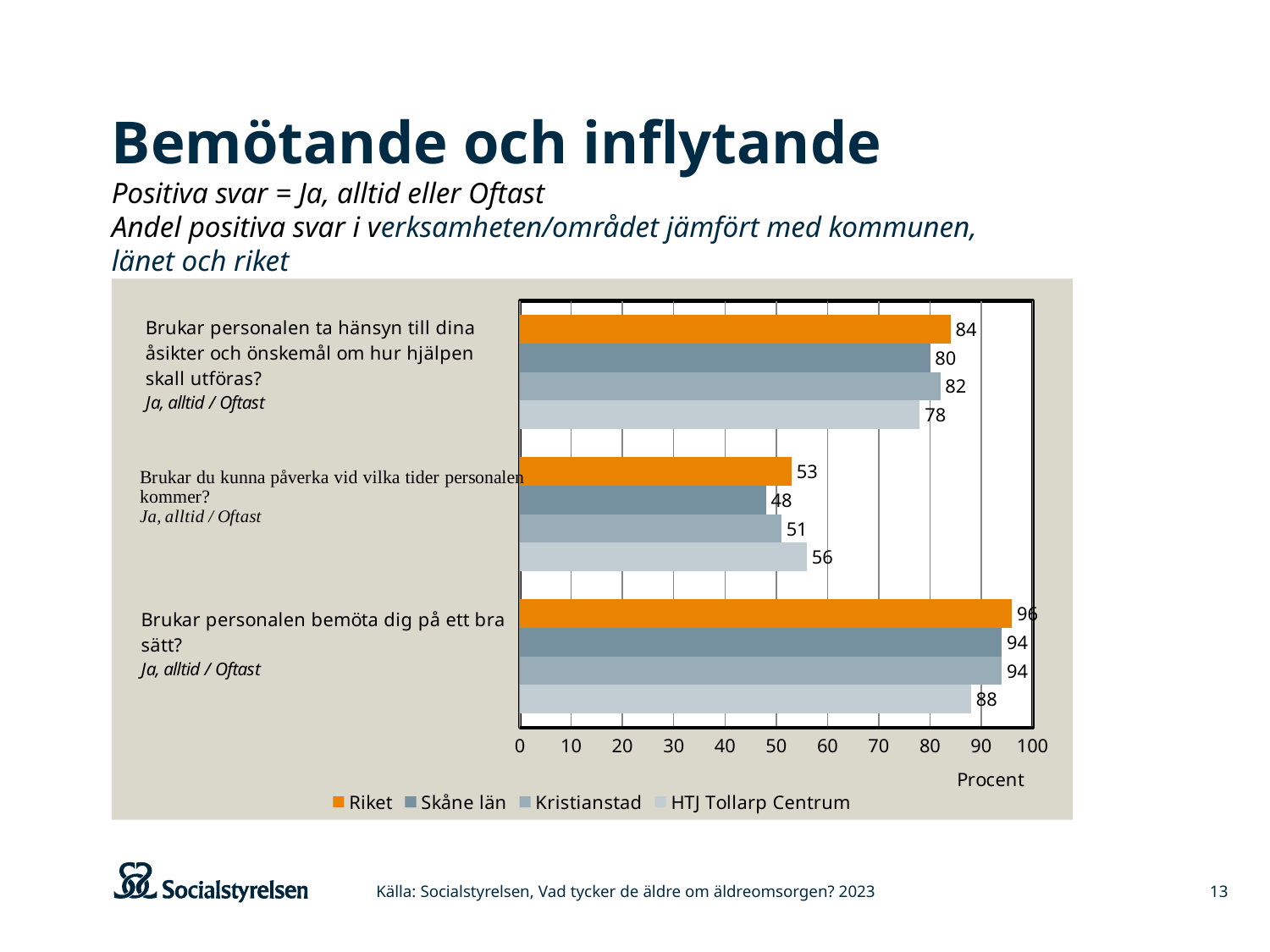
How many question categories are shown on the chart? 3 What is the value for HTJ Tollarp Centrum on the question "Brukar du kunna påverka vid vilka tider personalen kommer?"? 56 Which is larger on the question "Brukar du kunna påverka vid vilka tider personalen kommer?": Riket or HTJ Tollarp Centrum? HTJ Tollarp Centrum What label is shown on the horizontal axis of the chart? Procent Which series has the highest value on the question "Brukar personalen ta hänsyn till dina åsikter och önskemål om hur hjälpen skall utföras?"? Riket What is the value for Skåne län on the question "Brukar personalen ta hänsyn till dina åsikter och önskemål om hur hjälpen skall utföras?"? 80 What type of chart is shown on the slide? Bar chart What is the value for Riket on the question "Brukar personalen bemöta dig på ett bra sätt?"? 96 How many series does the legend list? 4 What is the difference between Riket and HTJ Tollarp Centrum on the question "Brukar personalen bemöta dig på ett bra sätt?"? 8 What is the value for Kristianstad on the question "Brukar personalen bemöta dig på ett bra sätt?"? 94 Which series has the lowest value on the question "Brukar du kunna påverka vid vilka tider personalen kommer?"? Skåne län